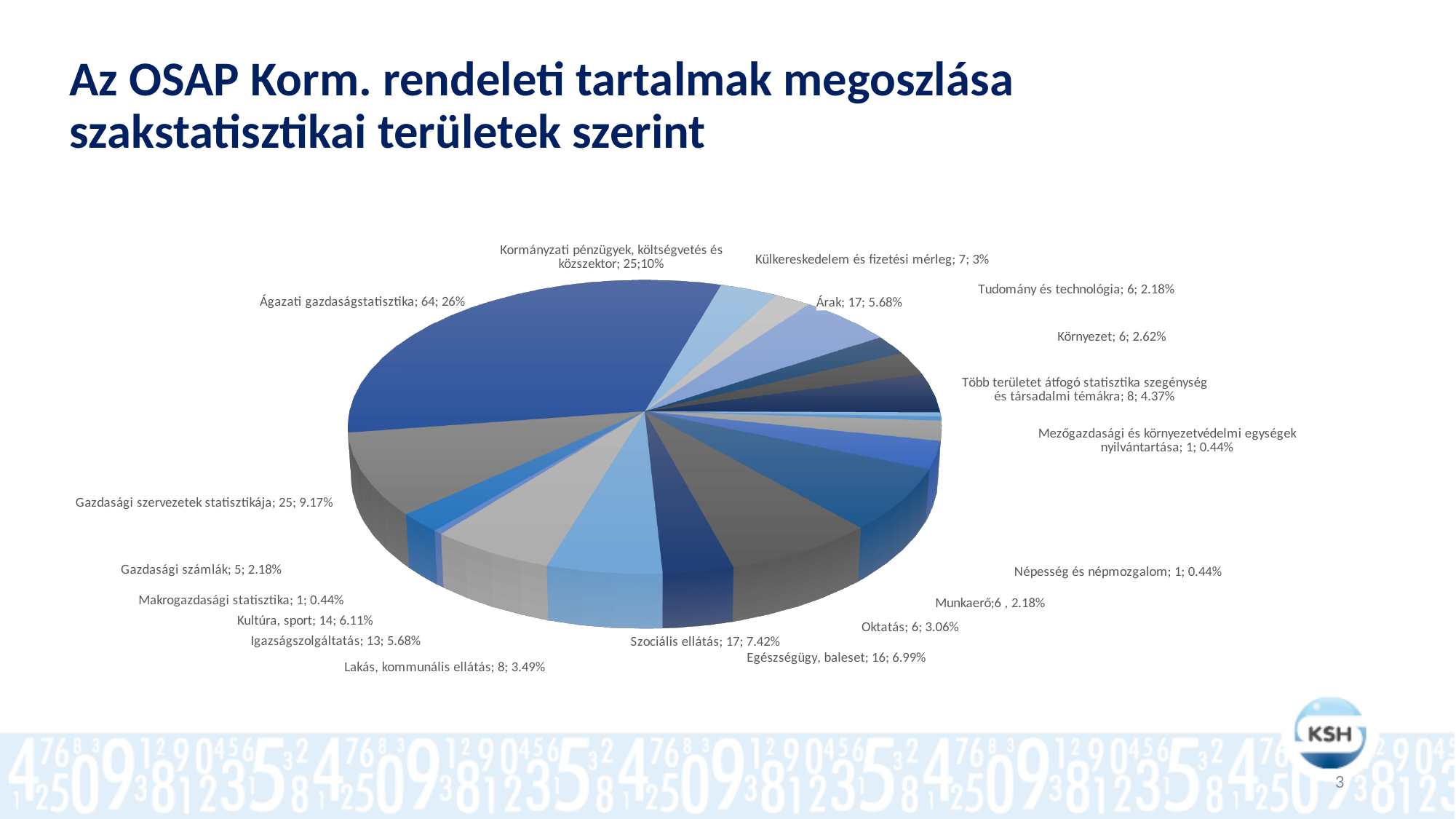
Which category has the largest slice in the pie chart? Ágazati gazdaságstatisztika What count is shown for Ágazati gazdaságstatisztika? 64 What count is shown for Szociális ellátás? 17 What percentage is shown for Több területet átfogó statisztika szegénység és társadalmi témákra? 4.37% What is the difference in count between Ágazati gazdaságstatisztika and Gazdasági szervezetek statisztikája? 39 What share of the pie does Ágazati gazdaságstatisztika represent? 26% Which has a larger count, Igazságszolgáltatás or Kultúra, sport? Kultúra, sport How many categories (slices) does the pie chart have? 19 What percentage is shown for Egészségügy, baleset? 6.99% What is the title of the slide containing the pie chart? Az OSAP Korm. rendeleti tartalmak megoszlása szakstatisztikai területek szerint What kind of chart is shown on the slide? pie chart What count is shown for Kultúra, sport? 14